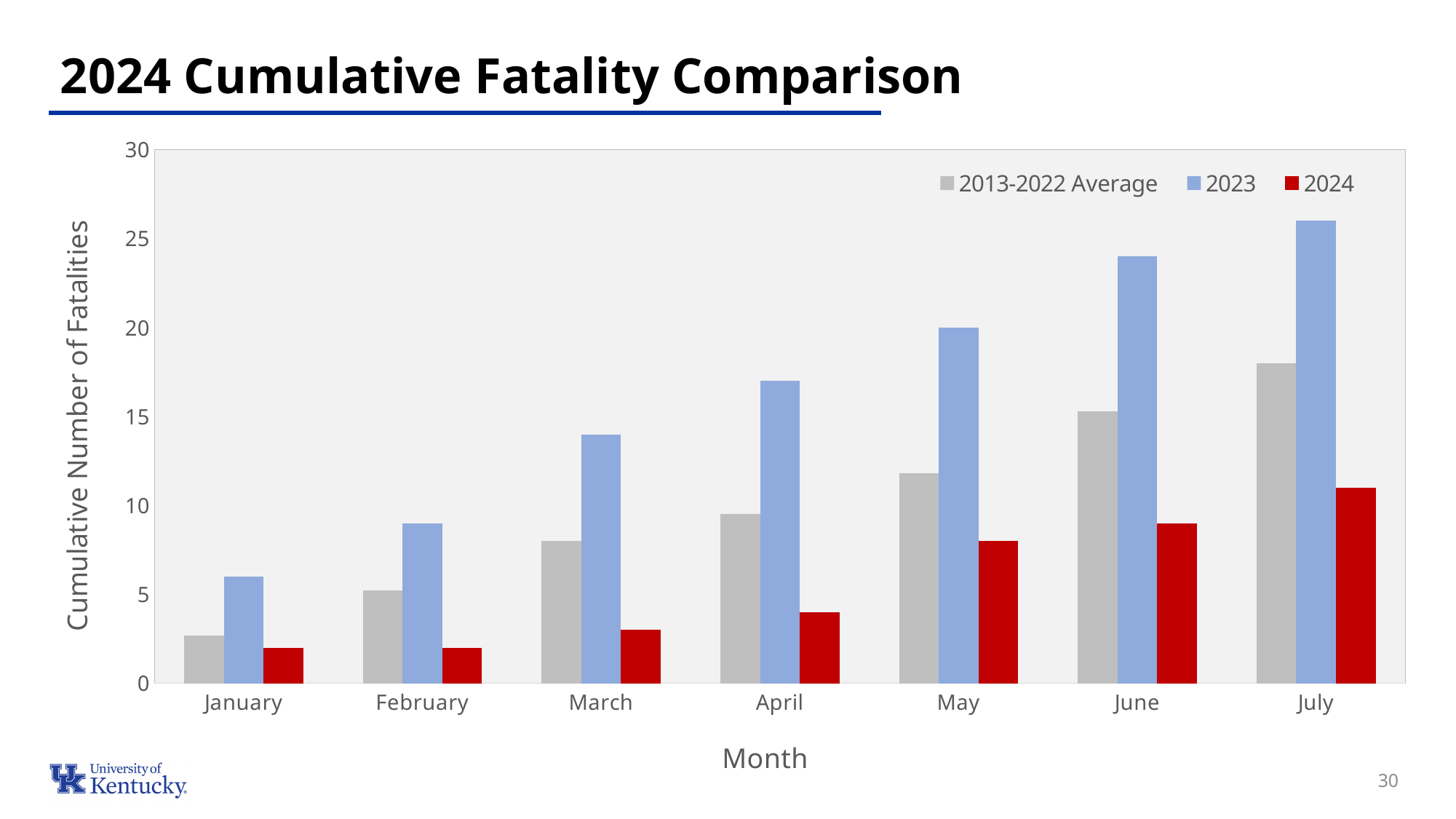
How many series does the legend list? 3 Which month has the highest 2023 value? July Is the 2023 value for July greater or less than 25? greater How many months are shown on the x axis? 7 What colour are the 2024 bars? red Is the 2024 value for July greater or less than 15? less Which is larger in April, the 2023 value or the 2024 value? 2023 Which month has the lowest 2013-2022 Average value? January Do the 2024 values rise or fall from January to July? rise What kind of chart is shown on the slide? bar chart What is the title of the chart? 2024 Cumulative Fatality Comparison